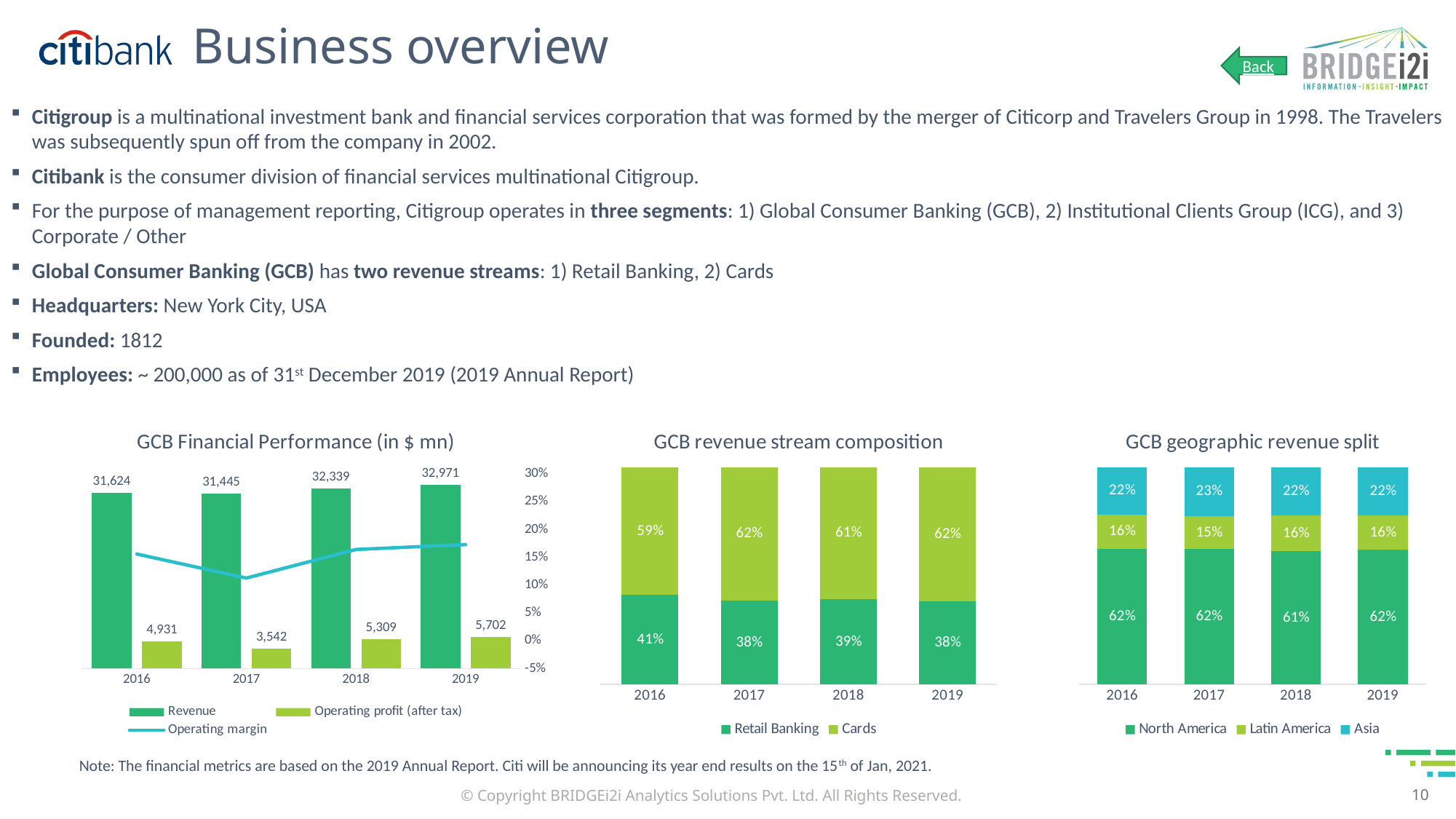
In the GCB Financial Performance chart, what was the revenue in 2019? 32,971 In the GCB Financial Performance chart, what was the operating profit (after tax) in 2017? 3,542 In the GCB revenue stream composition chart, which year had the highest Retail Banking share? 2016 In the GCB revenue stream composition chart, what kind of chart is shown? Stacked bar chart In the GCB geographic revenue split chart, what was Asia's share in 2017? 23% In the GCB Financial Performance chart, what is the difference between revenue in 2019 and revenue in 2018? 632 In the GCB revenue stream composition chart, what share of revenue came from Cards in 2016? 59% In the GCB Financial Performance chart, which year had the lowest operating profit (after tax)? 2017 In the GCB Financial Performance chart, is the operating margin for 2017 greater or less than 15%? less In the GCB Financial Performance chart, how many series does the legend list? 3 In the GCB geographic revenue split chart, which region is larger in 2019, Latin America or Asia? Asia In the GCB geographic revenue split chart, how many years are shown on the x axis? 4